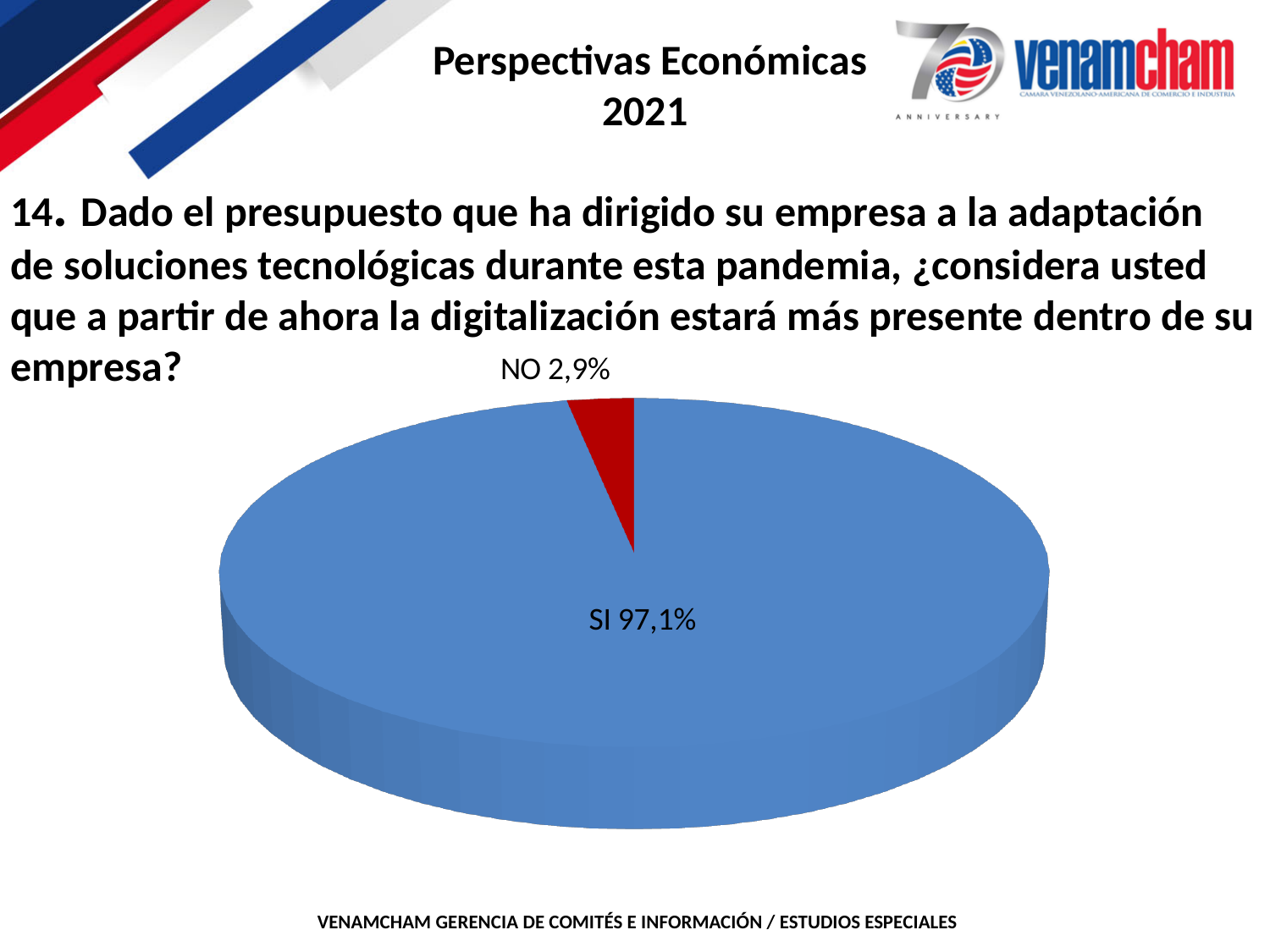
How many slices does the pie chart have? 2 What kind of chart is shown on the slide? Pie chart What colour is the NO slice of the pie? Red Which slice of the pie is the largest? SI What share of the pie does the NO slice represent? 2,9% What is the total of the two slices shown in the pie chart? 100% Which is larger, the SI slice or the NO slice? SI What colour is the SI slice of the pie? Blue What is the difference in percentage points between the SI and NO slices? 94,2 Which slice of the pie is the smallest? NO What share of the pie does the SI slice represent? 97,1%